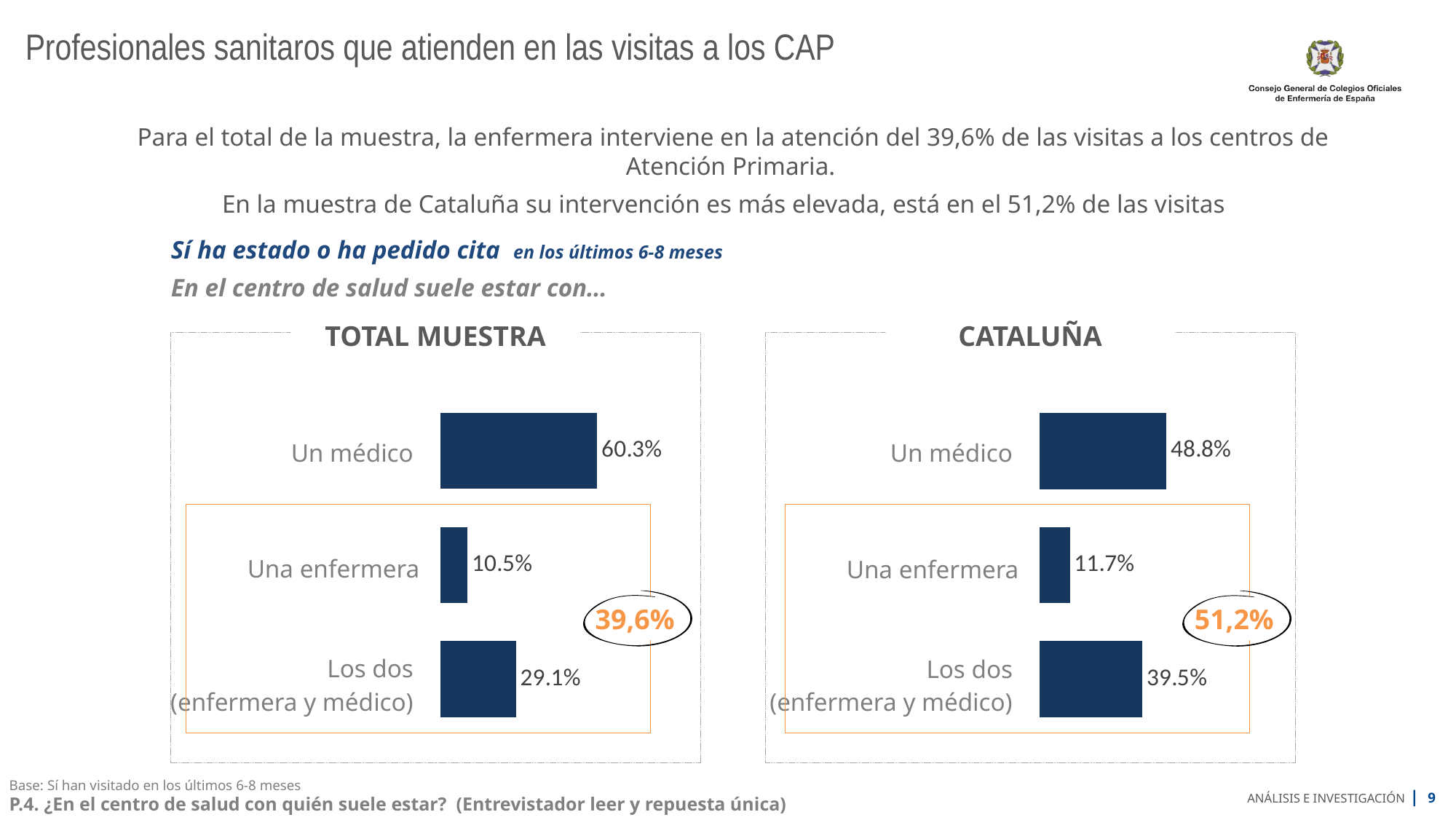
In the CATALUÑA chart, what is the difference between Un médico and Una enfermera? 37.1% In the TOTAL MUESTRA chart, what is the value for Un médico? 60.3% In the TOTAL MUESTRA chart, what is the value for Una enfermera? 10.5% Which is larger: Una enfermera in the TOTAL MUESTRA chart or Una enfermera in the CATALUÑA chart? CATALUÑA In the TOTAL MUESTRA chart, what is the difference between Un médico and Los dos (enfermera y médico)? 31.2% In the TOTAL MUESTRA chart, which category has the highest value? Un médico How many categories does the CATALUÑA chart show? 3 In the CATALUÑA chart, what is the value for Un médico? 48.8% In the CATALUÑA chart, which category has the lowest value? Una enfermera What value is circled in orange next to the CATALUÑA chart? 51,2% In the CATALUÑA chart, what is the value for Los dos (enfermera y médico)? 39.5% What kind of chart is the TOTAL MUESTRA chart? Bar chart